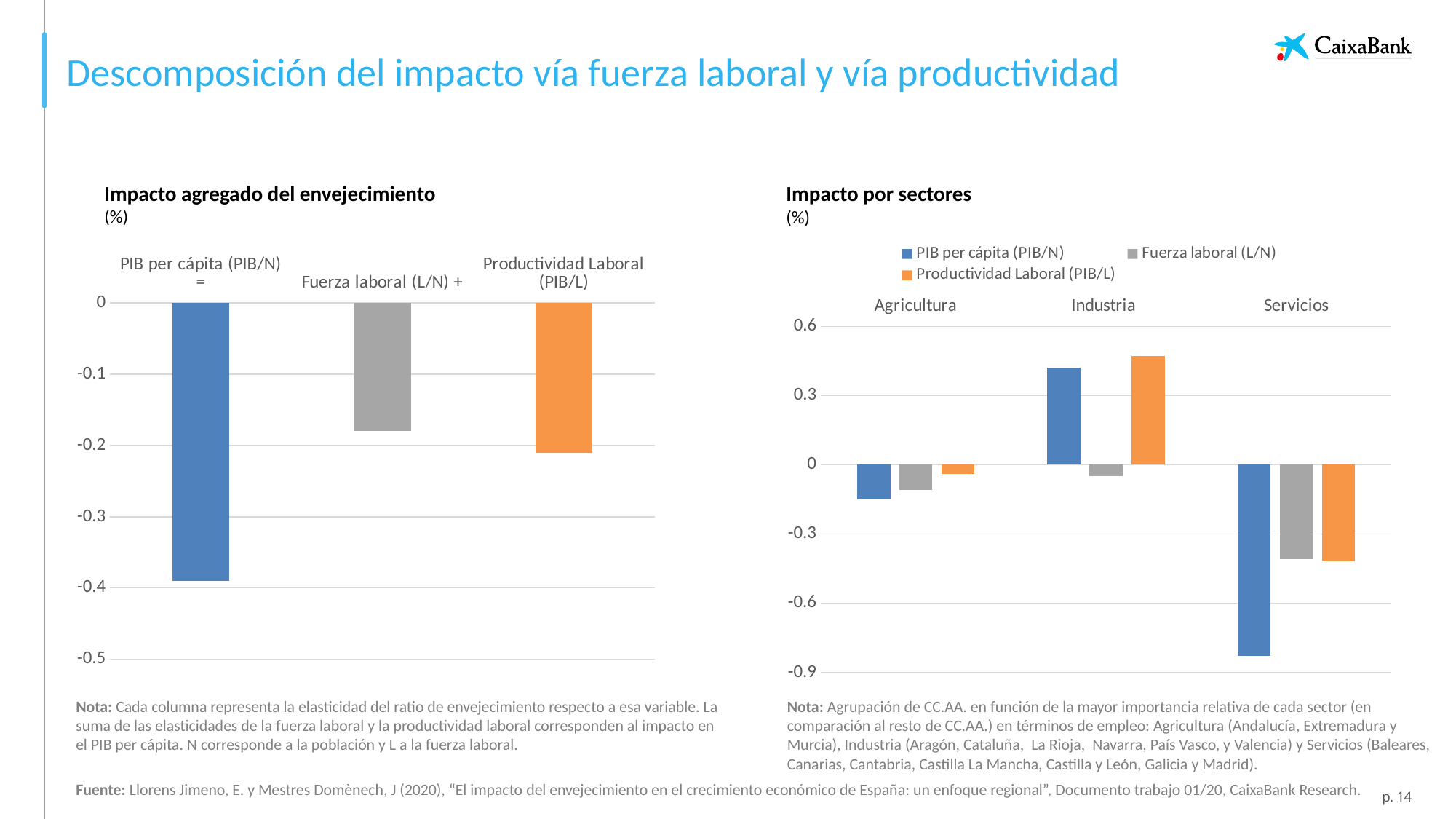
How many series does the legend of the 'Impacto por sectores' chart on the right list? 3 How many bars are plotted in the 'Impacto agregado del envejecimiento' chart on the left? 3 In the 'Impacto agregado del envejecimiento' chart on the left, is the value for Fuerza laboral (L/N) greater or less than -0.2? greater In the 'Impacto agregado del envejecimiento' chart on the left, is the value for PIB per cápita (PIB/N) greater or less than -0.3? less In the 'Impacto por sectores' chart on the right, which sector has the lowest value for PIB per cápita (PIB/N)? Servicios In the 'Impacto agregado del envejecimiento' chart on the left, which category has the lowest (most negative) value? PIB per cápita (PIB/N) What kind of chart is the 'Impacto agregado del envejecimiento' chart on the left? bar chart How many sector categories are shown on the x axis of the 'Impacto por sectores' chart on the right? 3 In the 'Impacto agregado del envejecimiento' chart on the left, what colour is the Productividad Laboral (PIB/L) bar? orange In the 'Impacto por sectores' chart on the right, which is larger for Agricultura: PIB per cápita (PIB/N) or Productividad Laboral (PIB/L)? Productividad Laboral (PIB/L) In the 'Impacto por sectores' chart on the right, is the value for Productividad Laboral (PIB/L) in Industria greater or less than 0.3? greater